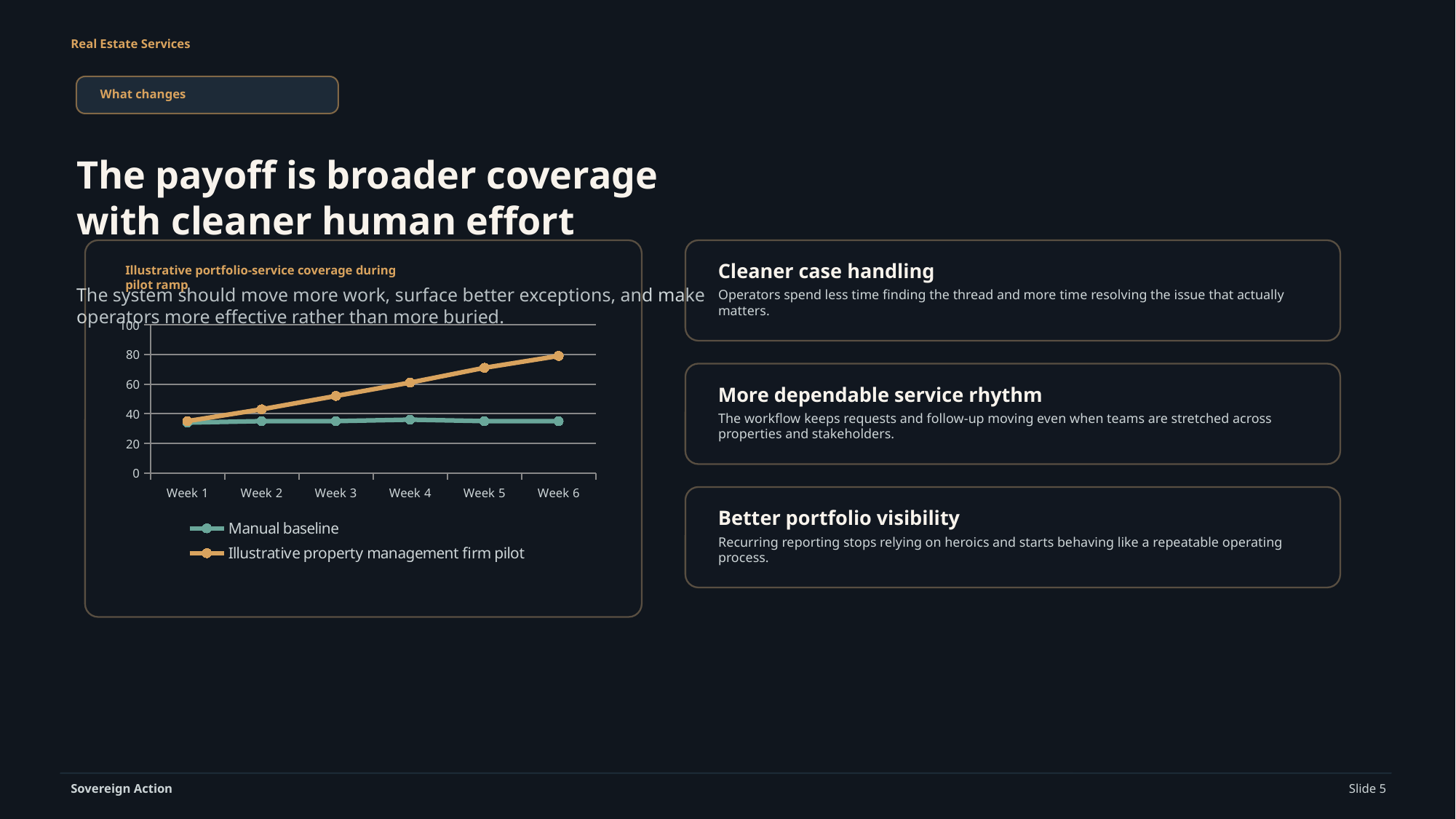
Is the value for the Illustrative property management firm pilot in Week 4 greater or less than 40? greater In Week 6, which series has the larger value: Manual baseline or Illustrative property management firm pilot? Illustrative property management firm pilot In which week does the Illustrative property management firm pilot series reach its highest value? Week 6 How many weeks are plotted along the x axis of the chart? 6 Is the value for the Illustrative property management firm pilot in Week 6 greater or less than 60? greater In Week 3, which series has the larger value: Manual baseline or Illustrative property management firm pilot? Illustrative property management firm pilot What is the title of the chart? Illustrative portfolio-service coverage during pilot ramp Does the Illustrative property management firm pilot series rise or fall from Week 1 to Week 6? Rise How many series does the chart legend list? 2 Which series is drawn in orange in the chart? Illustrative property management firm pilot Is the value for the Manual baseline in Week 3 greater or less than 40? less What kind of chart is shown on the slide? Line chart